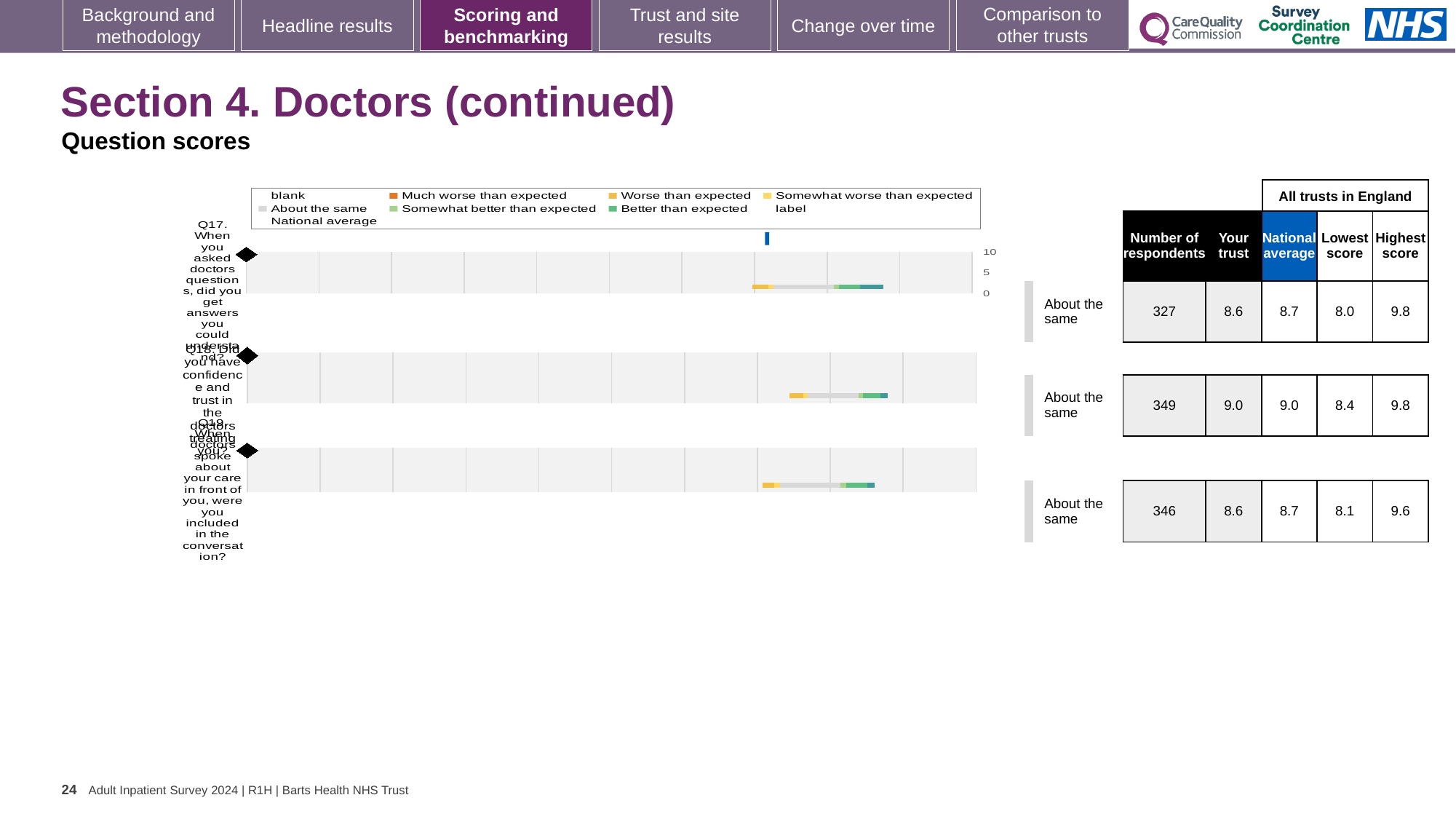
What is the difference between the highest score and the lowest score for Q18? 1.4 Which legend entry is shown in dark orange? Much worse than expected What is the 'Your trust' score for Q18 (confidence and trust in the doctors)? 9.0 What kind of chart is used to show the question scores on this slide? bar chart How many respondents are listed for Q17? 327 How many questions (categories) are plotted in the chart? 3 Which question has the highest 'Your trust' score? Q18 How many more respondents answered Q19 than Q17? 19 What is the lowest score among all trusts in England for Q17? 8.0 What is the national average score for Q19? 8.7 For Q17, which is larger: the 'Your trust' score or the national average? National average What benchmark category is shown for Q19? About the same